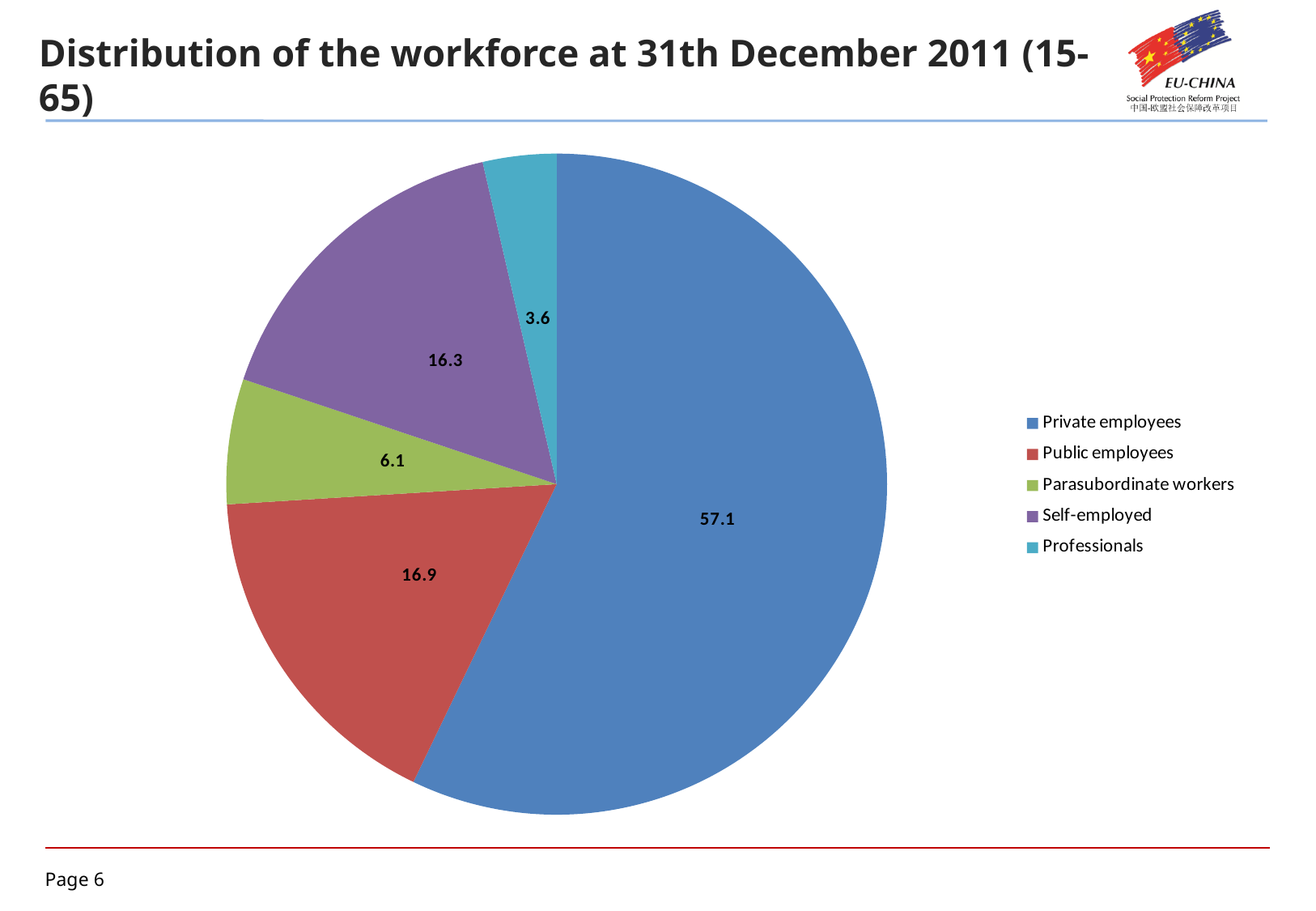
What is the value for Parasubordinate workers? 6.1 What is the difference between the values for Private employees and Public employees? 40.2 How many categories does the pie chart show? 5 What is the value for Private employees? 57.1 What colour is the slice for Self-employed? Purple What is the value for Professionals? 3.6 What is the value for Self-employed? 16.3 Which category has the largest slice? Private employees What is the value for Public employees? 16.9 Which category has the smallest slice? Professionals Which is larger, the value for Self-employed or the value for Parasubordinate workers? Self-employed What kind of chart is shown on the slide? Pie chart